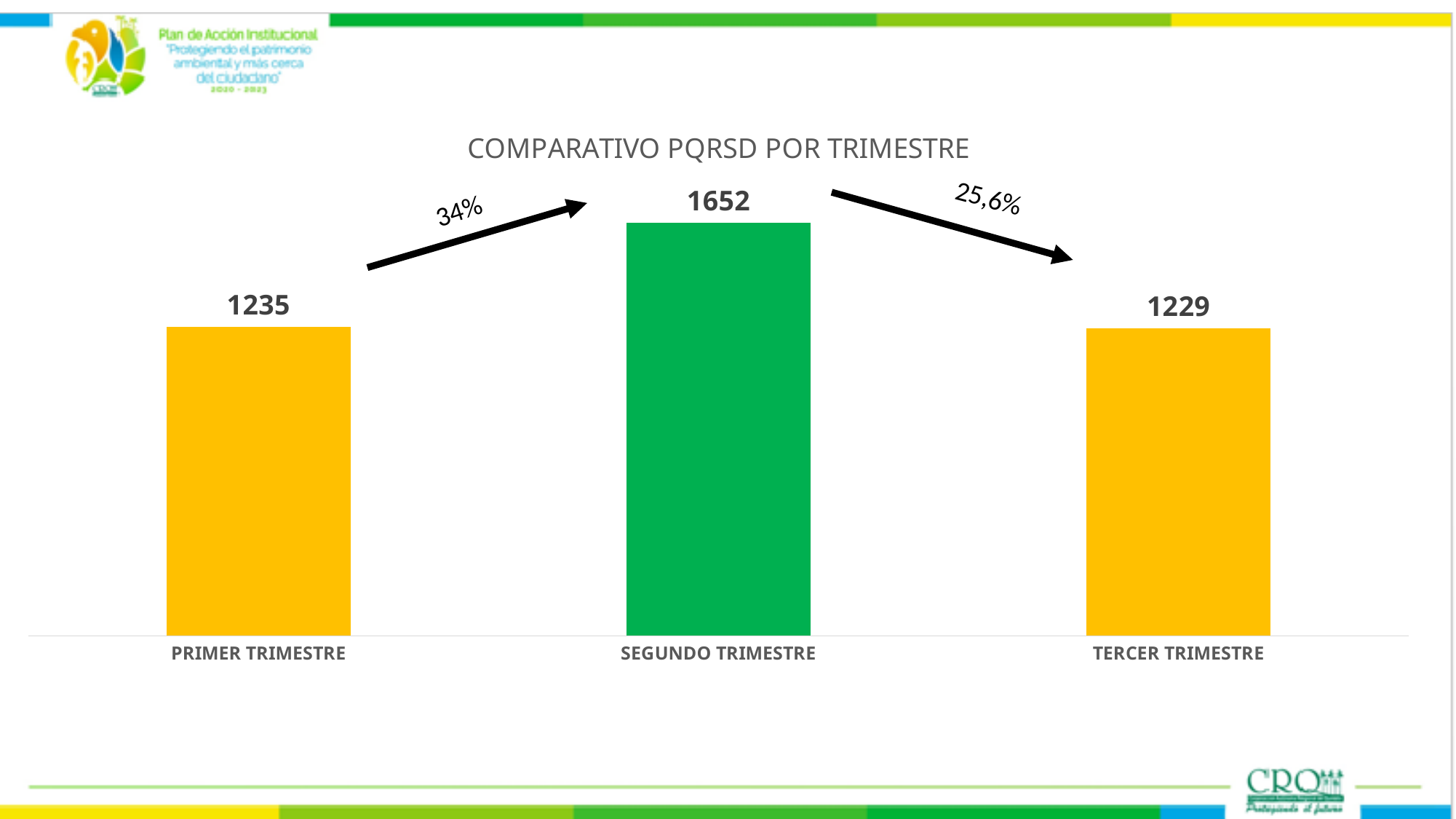
What is the difference between the values for SEGUNDO TRIMESTRE and TERCER TRIMESTRE? 423 What is the difference between the values for SEGUNDO TRIMESTRE and PRIMER TRIMESTRE? 417 What is the title of the chart? COMPARATIVO PQRSD POR TRIMESTRE What percentage change is labelled on the arrow from PRIMER TRIMESTRE to SEGUNDO TRIMESTRE? 34% What is the value for TERCER TRIMESTRE? 1229 Which is larger, the value for PRIMER TRIMESTRE or SEGUNDO TRIMESTRE? SEGUNDO TRIMESTRE What is the value for SEGUNDO TRIMESTRE? 1652 What kind of chart is shown on the slide? Bar chart Which trimester has the highest value? SEGUNDO TRIMESTRE What is the value for PRIMER TRIMESTRE? 1235 Which trimester has the lowest value? TERCER TRIMESTRE How many trimesters are shown in the chart? 3